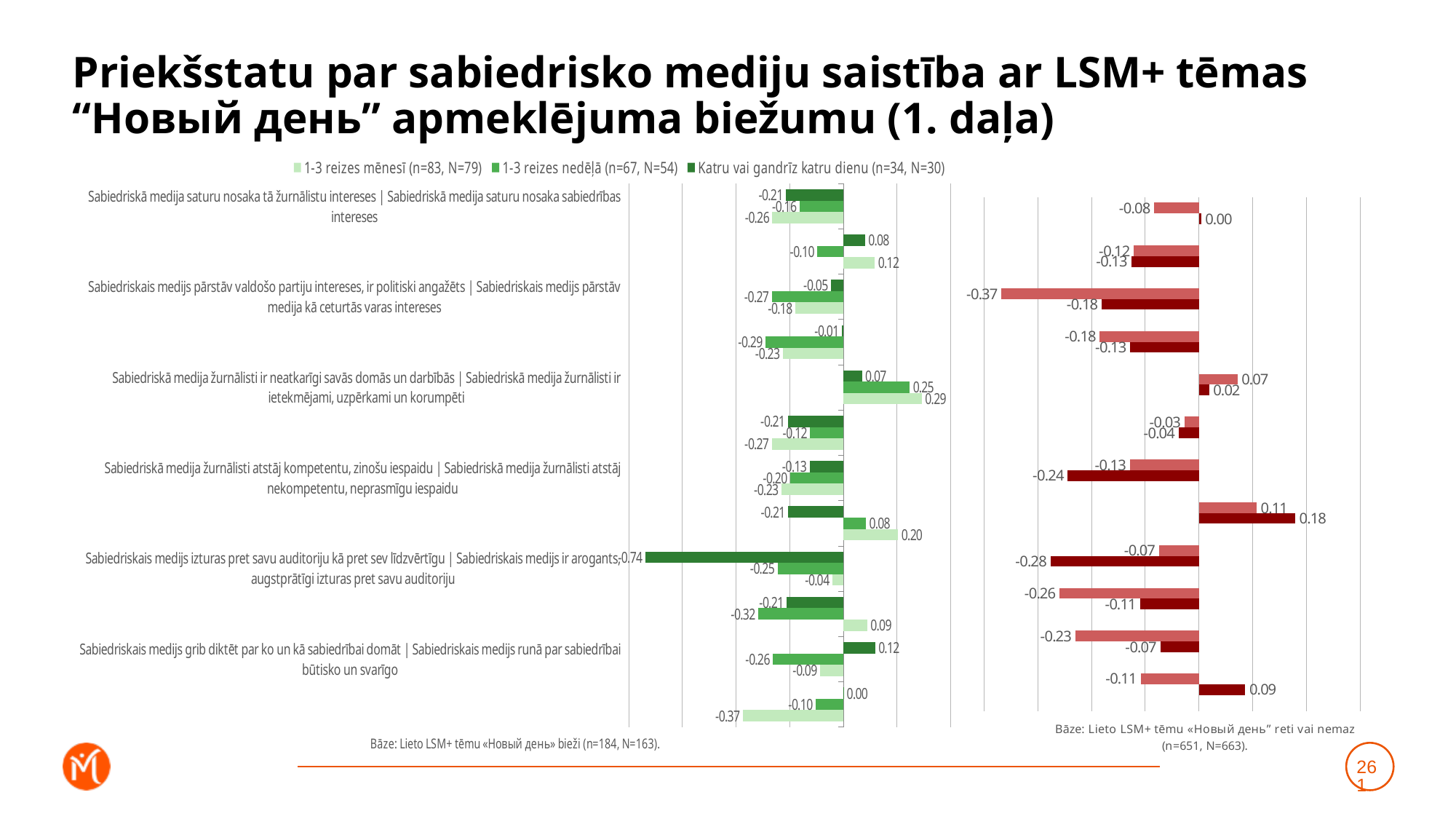
In the left (green) chart, what is the lowest value shown in the whole chart? -0.74 In the left (green) chart, what is the value for 'Katru vai gandrīz katru dienu' for the statement 'Sabiedriskais medijs izturas pret savu auditoriju kā pret sev līdzvērtīgu | Sabiedriskais medijs ir arogants, augstprātīgi izturas pret savu auditoriju'? -0.74 In the left (green) chart, what is the value for '1-3 reizes mēnesī' for the statement 'Sabiedriskā medija žurnālisti atstāj kompetentu, zinošu iespaidu | Sabiedriskā medija žurnālisti atstāj nekompetentu, neprasmīgu iespaidu'? -0.23 In the right (red) chart, what is the lowest value shown? -0.37 In the left (green) chart, for the statement 'Sabiedriskais medijs pārstāv valdošo partiju intereses, ir politiski angažēts | ...', which series has the larger value: 'Katru vai gandrīz katru dienu' or '1-3 reizes nedēļā'? Katru vai gandrīz katru dienu In the left (green) chart, what is the value for '1-3 reizes nedēļā' for the statement 'Sabiedriskā medija žurnālisti ir neatkarīgi savās domās un darbībās | Sabiedriskā medija žurnālisti ir ietekmējami, uzpērkami un korumpēti'? 0.25 In the left (green) chart, for the statement 'Sabiedriskā medija žurnālisti ir neatkarīgi savās domās un darbībās | ...', what is the difference between the '1-3 reizes mēnesī' value and the 'Katru vai gandrīz katru dienu' value? 0.22 In the left (green) chart, what is the highest value shown in the whole chart? 0.29 In the left (green) chart, what is the value for 'Katru vai gandrīz katru dienu' for the statement 'Sabiedriskais medijs grib diktēt par ko un kā sabiedrībai domāt | Sabiedriskais medijs runā par sabiedrībai būtisko un svarīgo'? 0.12 What type of chart is shown on the left side of the slide? bar chart How many series does the legend of the left (green) chart list? 3 In the left (green) chart, what is the value for '1-3 reizes mēnesī' for the statement 'Sabiedriskā medija saturu nosaka tā žurnālistu intereses | Sabiedriskā medija saturu nosaka sabiedrības intereses'? -0.26